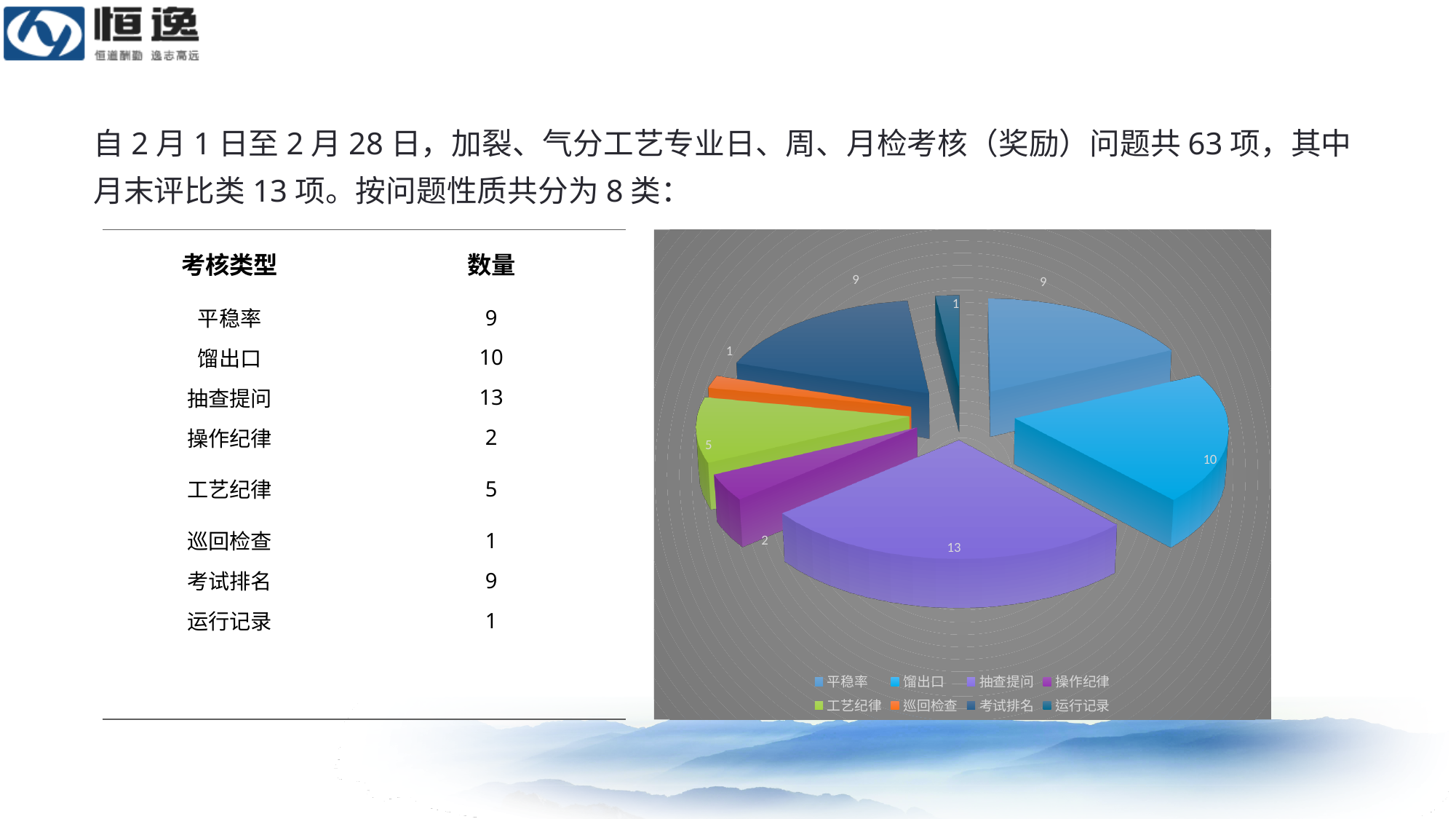
What is the value for 操作纪律 in the pie chart? 2 Which is larger, the value for 馏出口 or the value for 考试排名? 馏出口 Which category has the largest slice in the pie chart? 抽查提问 What kind of chart is shown on the slide? Pie chart Which is larger, the value for 工艺纪律 or the value for 操作纪律? 工艺纪律 What is the value for 馏出口 in the pie chart? 10 How many categories does the pie chart show? 8 What is the difference between the values for 平稳率 and 工艺纪律? 4 What is the difference between the values for 抽查提问 and 馏出口? 3 What is the value for 抽查提问 in the pie chart? 13 How many entries does the legend of the pie chart list? 8 What is the value for 工艺纪律 in the pie chart? 5